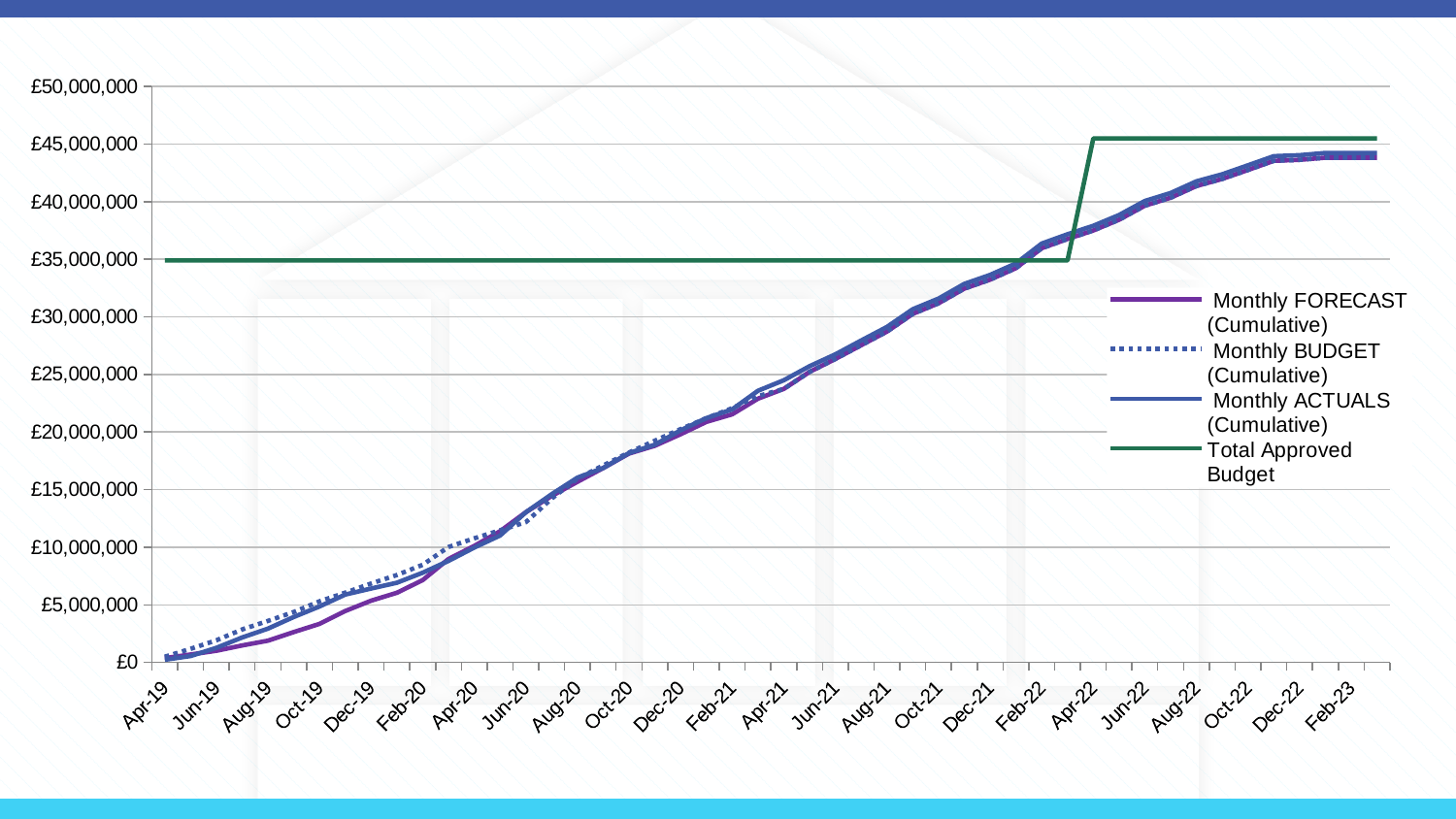
At Feb-23, which is higher: Total Approved Budget or Monthly ACTUALS (Cumulative)? Total Approved Budget Is the value of Monthly ACTUALS (Cumulative) at Oct-20 greater or less than £20,000,000? less Is the value of Total Approved Budget at Feb-23 greater or less than £40,000,000? greater What kind of chart is shown on the slide? Line chart At Oct-19, which is higher: Monthly BUDGET (Cumulative) or Monthly FORECAST (Cumulative)? Monthly BUDGET (Cumulative) Is the value of Total Approved Budget at Apr-19 greater or less than £40,000,000? less Which series is drawn as a dotted line? Monthly BUDGET (Cumulative) What colour is the Total Approved Budget line? Green How many series does the legend list? 4 Does the Monthly ACTUALS (Cumulative) line rise or fall from Apr-19 to Feb-23? Rise